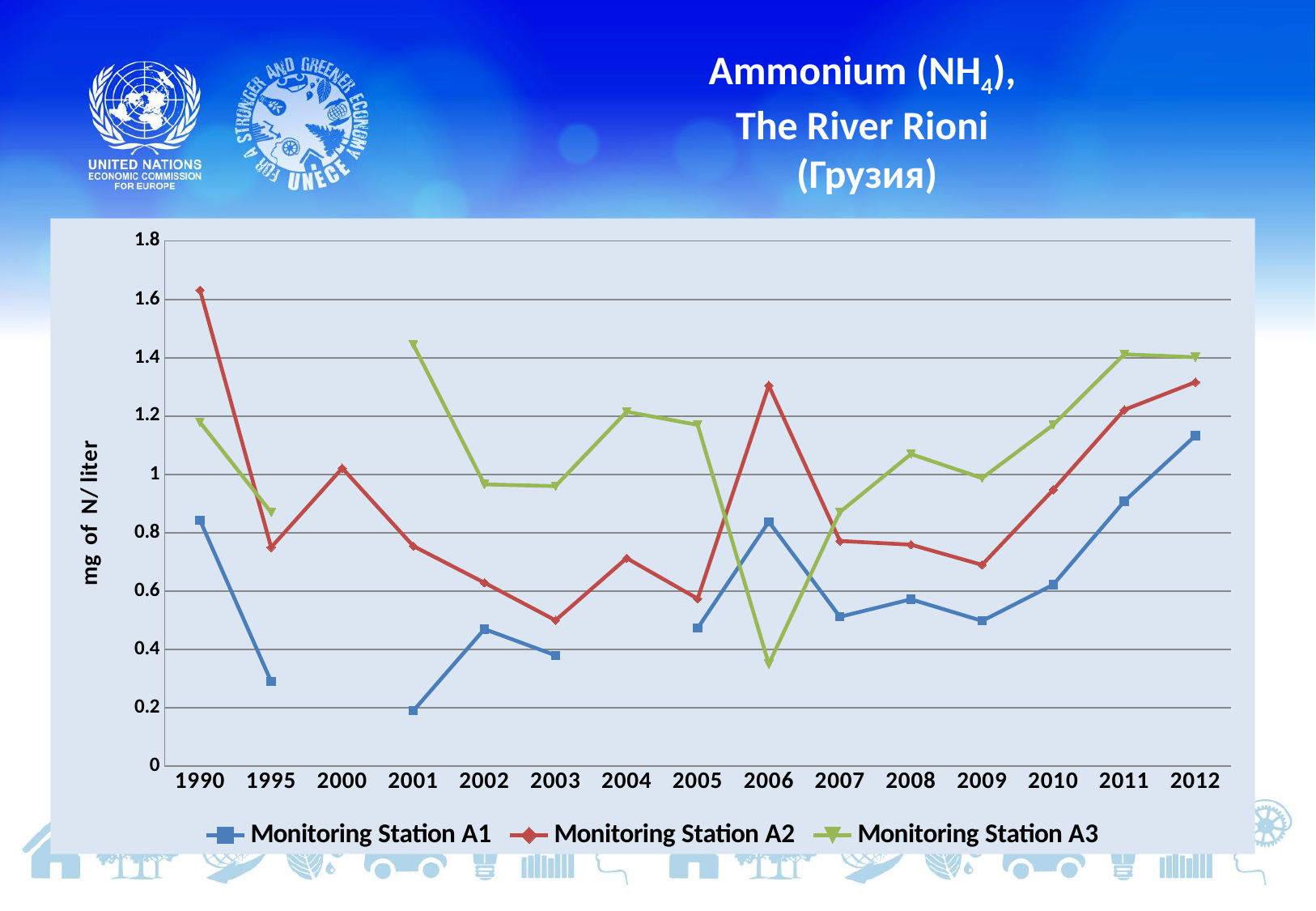
How many years are shown on the x axis? 15 What is the label of the y axis? mg of N/ liter Is the value for Monitoring Station A2 in 1990 greater or less than 1.4? greater Which is larger for Monitoring Station A1: the value in 2006 or the value in 2012? 2012 Is the value for Monitoring Station A1 in 2012 greater or less than 1? greater Is the value for Monitoring Station A1 in 2001 greater or less than 0.4? less Which monitoring station is represented by the green line? Monitoring Station A3 In which year does Monitoring Station A2 reach its highest value? 1990 What kind of chart is shown on the slide? line chart How many series does the legend list? 3 Which monitoring station has the lowest value in 2006? Monitoring Station A3